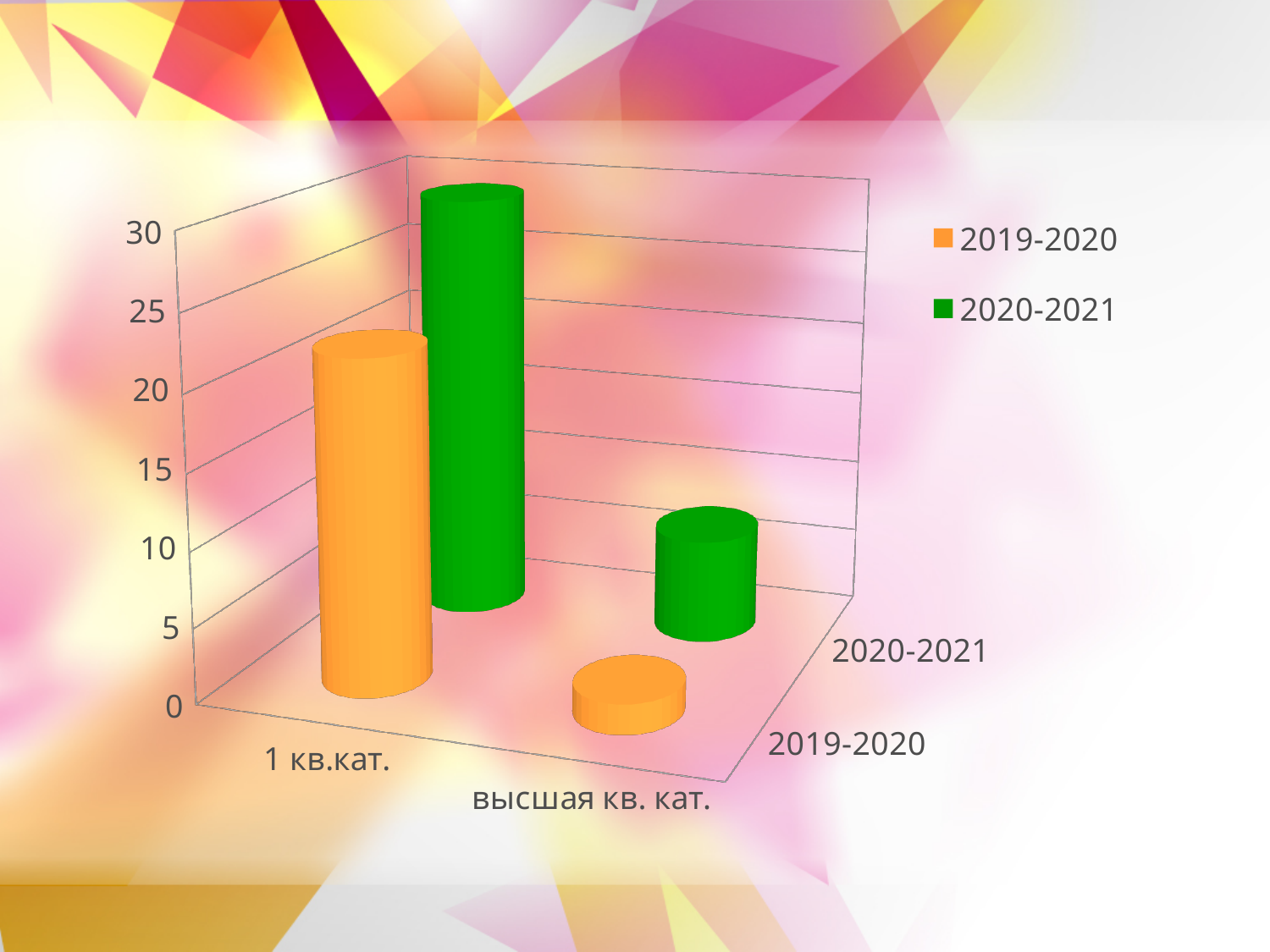
What kind of chart is shown on the slide? bar chart For the 2019-2020 series, which category has the larger value: 1 кв.кат. or высшая кв. кат.? 1 кв.кат. Which series is shown in green in the legend? 2020-2021 How many categories are shown on the category axis? 2 Which series is shown in orange in the legend? 2019-2020 Is the 2019-2020 value for высшая кв. кат. greater or less than 5? less For the category 1 кв.кат., which series has the larger value: 2019-2020 or 2020-2021? 2020-2021 Is the 2019-2020 value for 1 кв.кат. greater or less than 15? greater Which category has the highest value for the 2020-2021 series? 1 кв.кат. Which category has the lowest value for the 2019-2020 series? высшая кв. кат. Is the 2020-2021 value for высшая кв. кат. greater or less than 15? less How many series does the legend list? 2